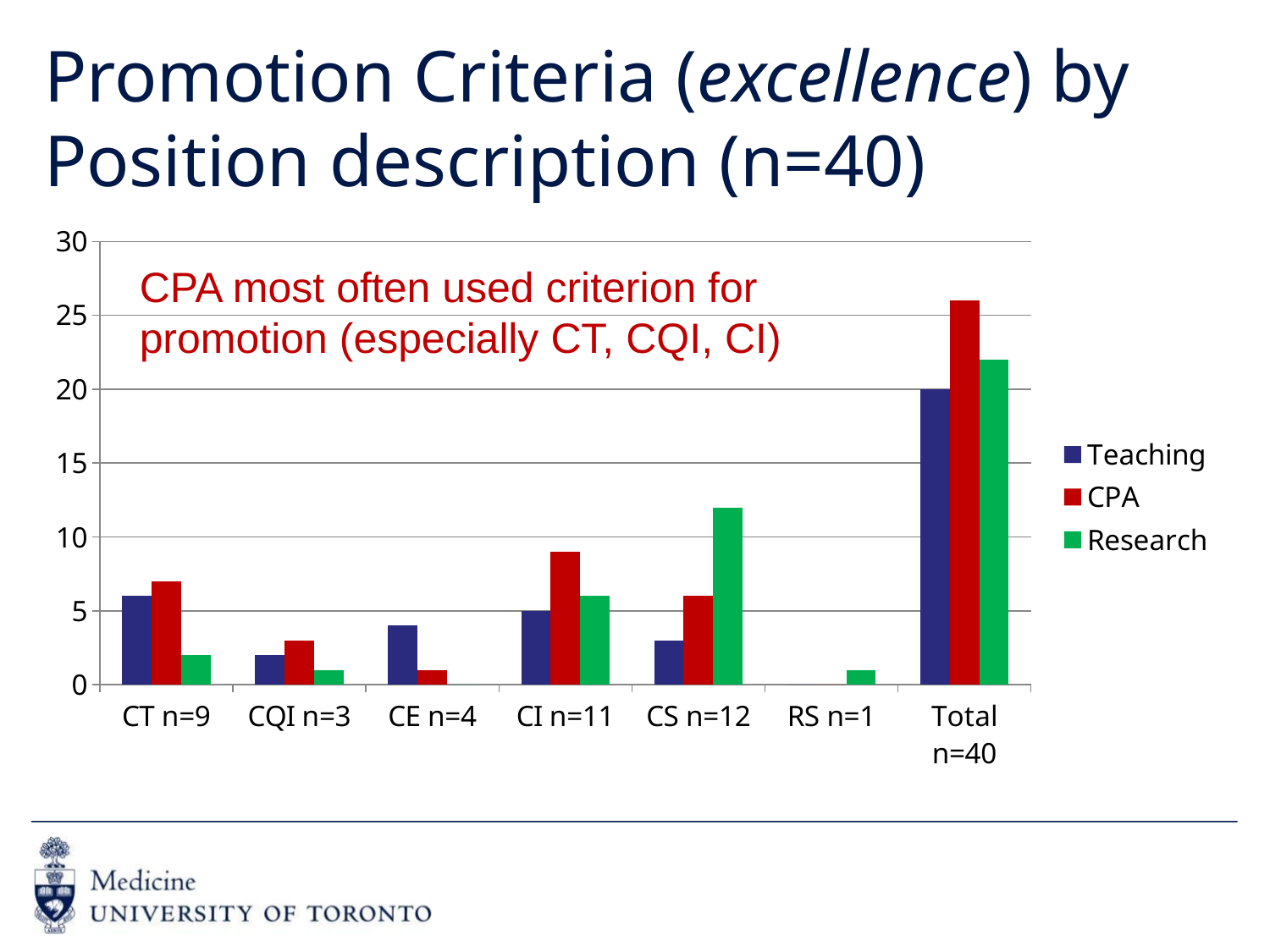
Which series is shown in green in the legend? Research What is the Teaching value for Total n=40? 20 How many series does the legend list? 3 What kind of chart is shown on the slide? bar chart How many categories are shown along the x axis? 7 Is the CPA value for Total n=40 greater or less than 25? greater Is the Research value for CS n=12 greater or less than 10? greater For CI n=11, which is larger, the CPA value or the Teaching value? CPA Is the Teaching value for CE n=4 greater or less than 5? less What is the Teaching value for CI n=11? 5 Excluding Total n=40, which category has the highest Research value? CS n=12 Which category has the highest CPA value? Total n=40